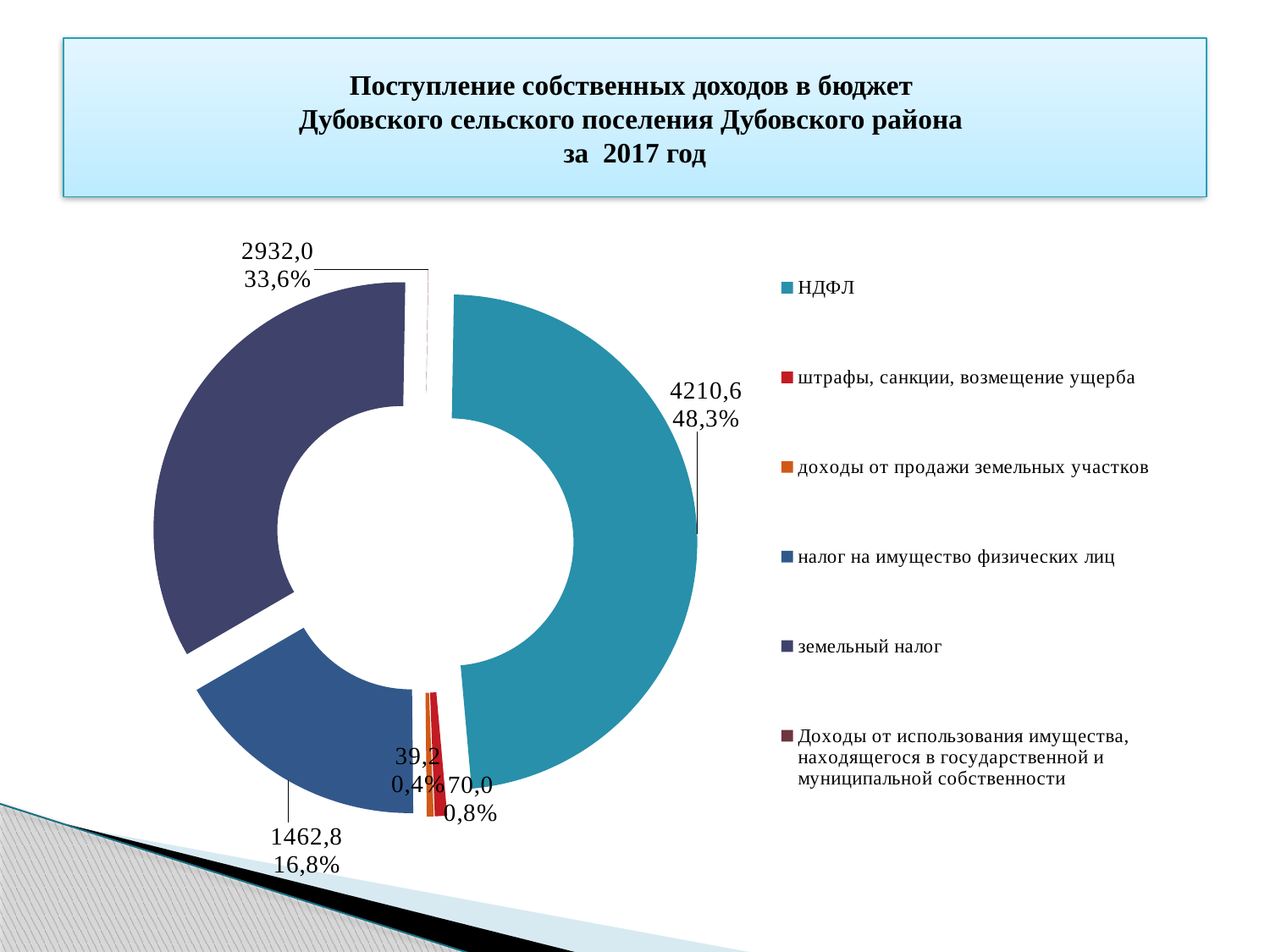
For which year does the chart title say the revenue data is shown? 2017 What is the value shown for налог на имущество физических лиц? 1462,8 What is the value shown for НДФЛ? 4210,6 Which category has the largest slice of the chart? НДФЛ What is the difference between the values for НДФЛ and земельный налог? 1278,6 What is the value shown for земельный налог? 2932,0 What share of the total does земельный налог account for? 33,6% Which is larger: земельный налог or налог на имущество физических лиц? земельный налог What share of the total does налог на имущество физических лиц account for? 16,8% How many categories does the legend list? 6 What kind of chart is shown on the slide? Doughnut (pie) chart What share of the total does НДФЛ account for? 48,3%